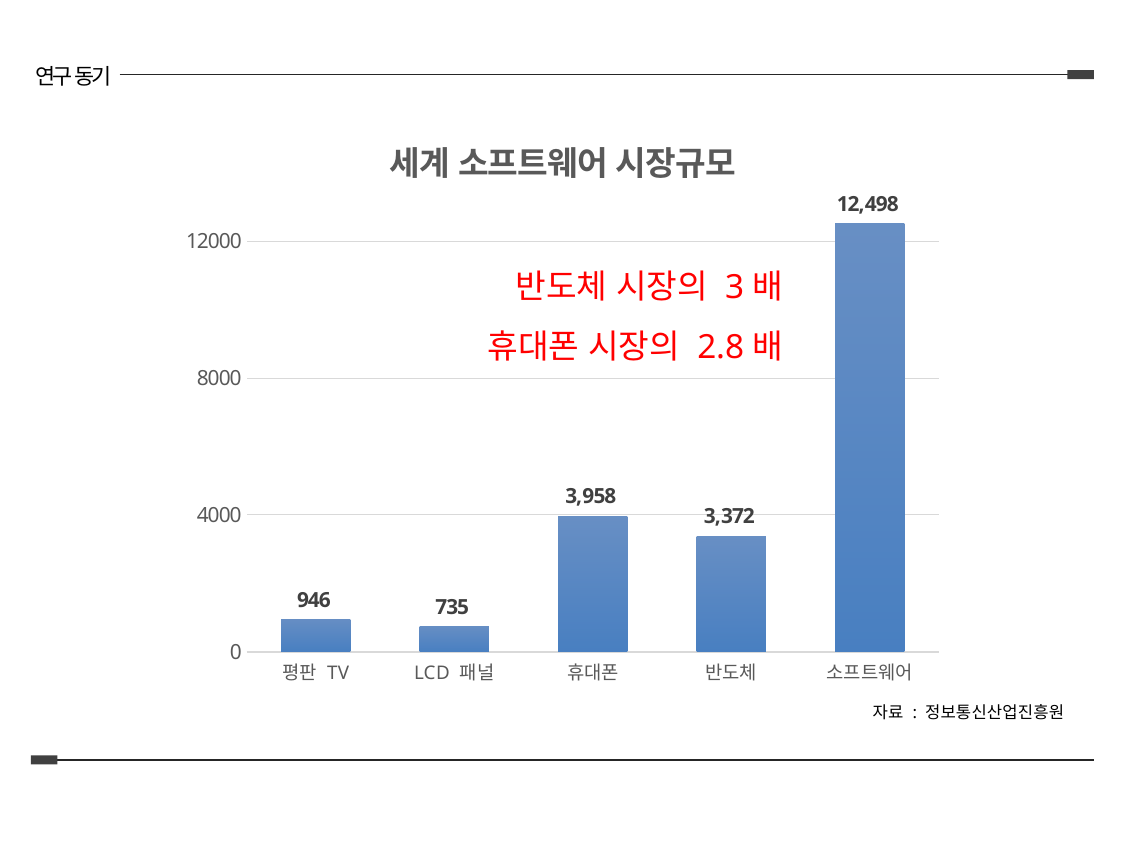
What is the difference between the values for 평판 TV and LCD 패널? 211 What is the value for 소프트웨어? 12,498 What kind of chart is shown on the slide? bar chart What is the difference between the values for 휴대폰 and 반도체? 586 Which is larger, the value for 휴대폰 or the value for 반도체? 휴대폰 How many categories are shown on the x axis? 5 What is the title of the chart? 세계 소프트웨어 시장규모 What is the value for LCD 패널? 735 Which category has the highest value? 소프트웨어 Is the value for 반도체 greater or less than 4000? less Which category has the lowest value? LCD 패널 What is the value for 휴대폰? 3,958